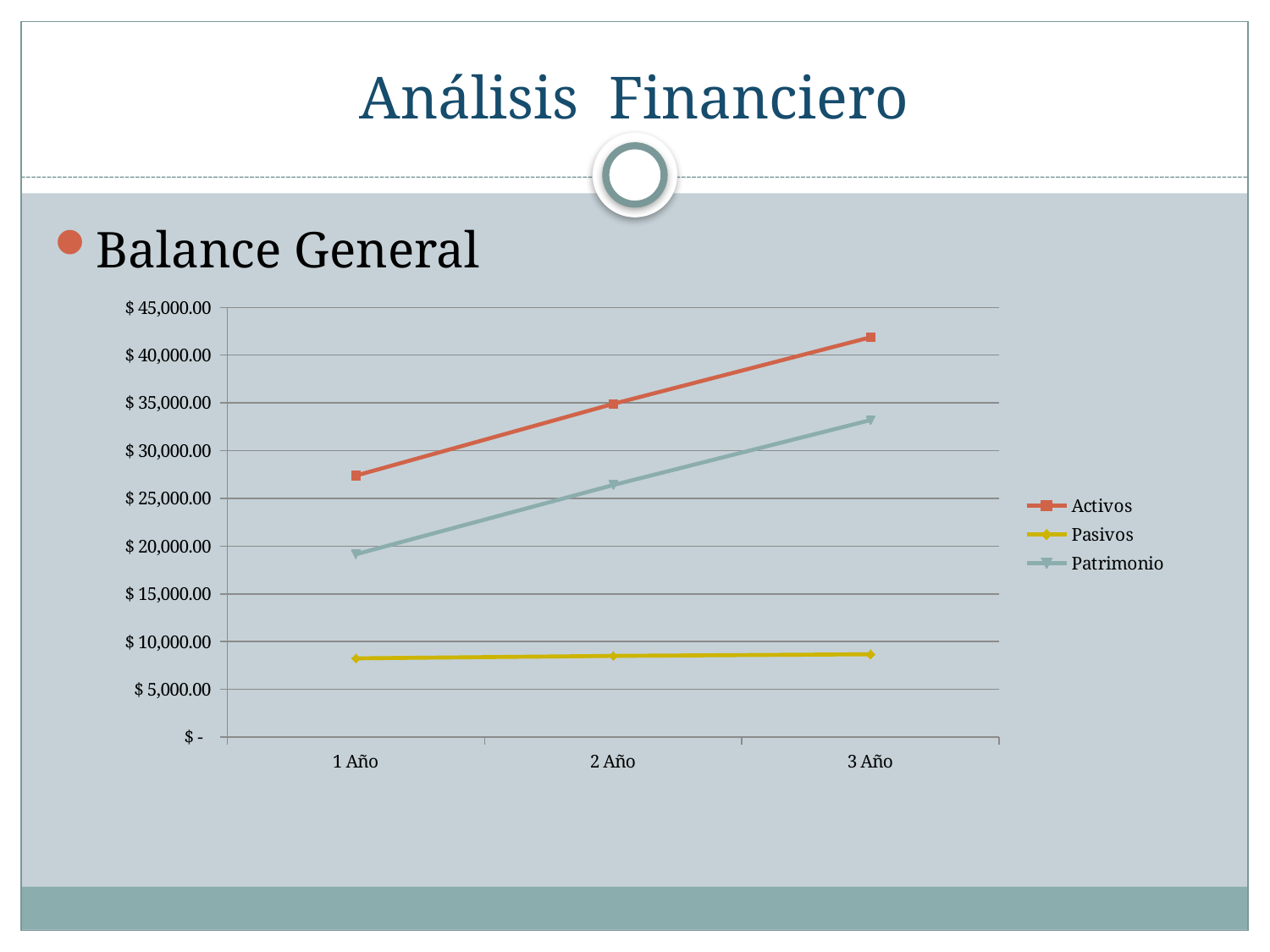
Do the values for Activos rise or fall from 1 Año to 3 Año? rise Is the value for Pasivos at 1 Año greater or less than $ 10,000.00? less How many points are there along the x axis? 3 What are the names of the three series in the legend? Activos, Pasivos, Patrimonio Which series has the highest value at 3 Año? Activos Is the value for Patrimonio at 3 Año greater or less than $ 30,000.00? greater What kind of chart is shown on the slide? Line chart Is the value for Activos at 3 Año greater or less than $ 40,000.00? greater Which series has the lowest value at 1 Año? Pasivos How many series does the legend list? 3 Which is larger at 2 Año, Activos or Patrimonio? Activos